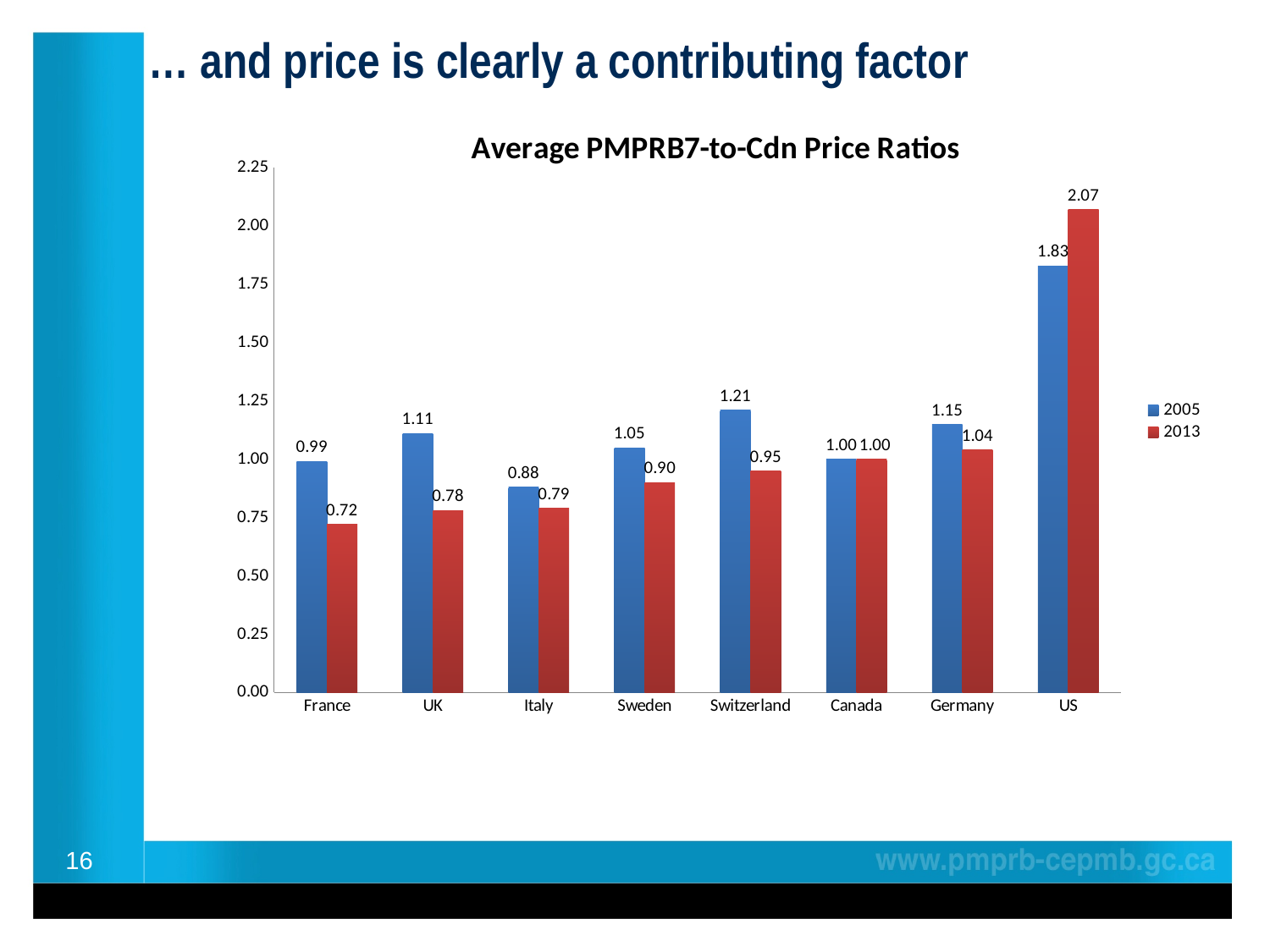
Which country has the lowest 2013 value? France How many countries are shown on the x axis? 8 What is the 2013 value for the US? 2.07 What kind of chart is this? Bar chart What is the difference between the 2013 and 2005 values for the US? 0.24 How many series does the legend list? 2 What is the title of the chart? Average PMPRB7-to-Cdn Price Ratios What is the 2013 value for Switzerland? 0.95 Which is larger for Germany, the 2005 value or the 2013 value? 2005 Which country has the highest 2013 value? US Which country has the lowest 2005 value? Italy What is the 2005 value for France? 0.99